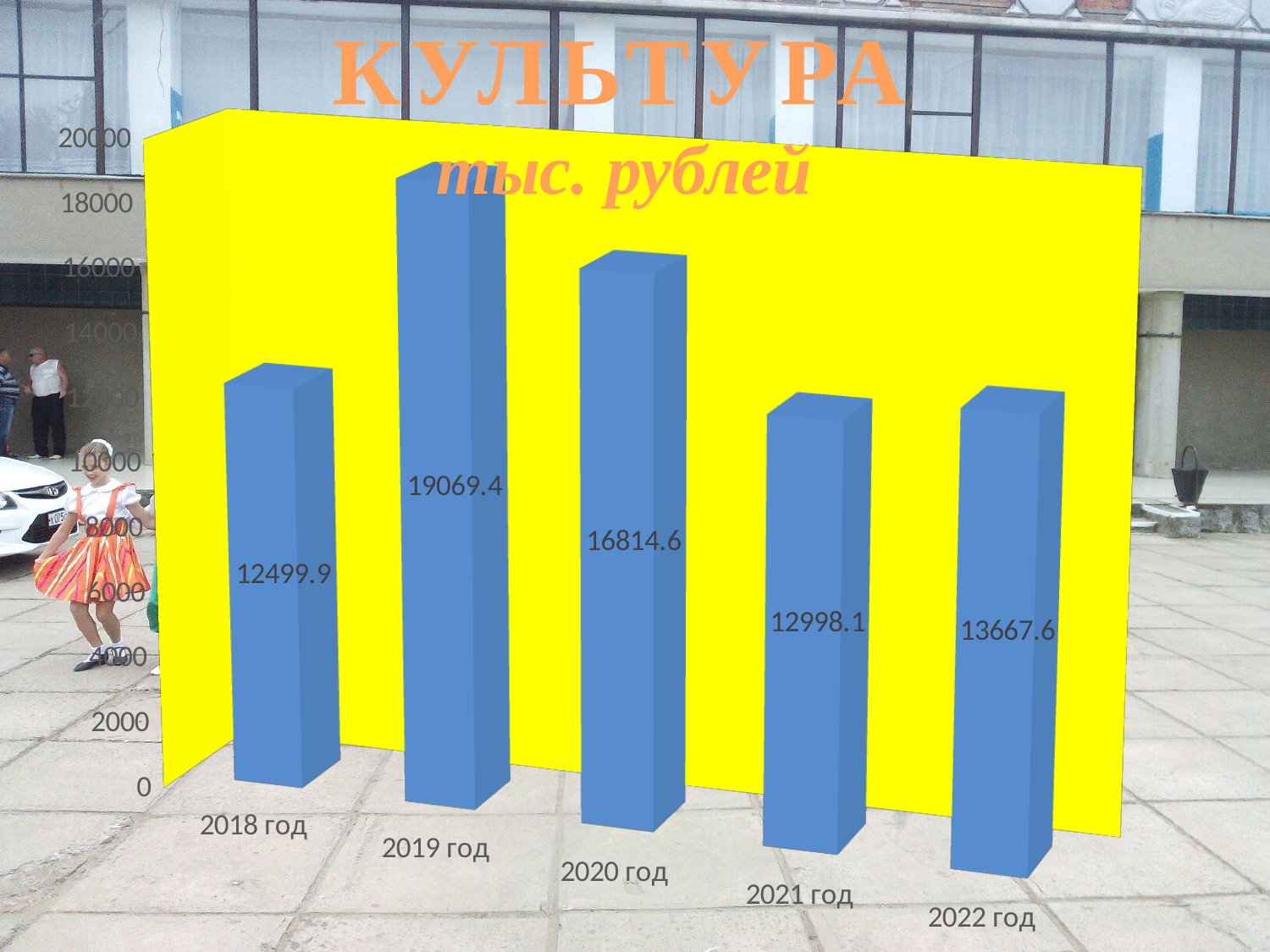
What is the difference between the values for 2019 год and 2018 год? 6569.5 Which year has the lowest value? 2018 год What kind of chart is shown on the slide? bar chart How many years are shown in the chart? 5 What is the value for 2019 год? 19069.4 What is the value for 2022 год? 13667.6 Which year has the highest value? 2019 год What is the difference between the values for 2022 год and 2021 год? 669.5 What is the value for 2020 год? 16814.6 What is the title of the chart? КУЛЬТУРА What is the value for 2018 год? 12499.9 Which is larger, the value for 2020 год or the value for 2021 год? 2020 год